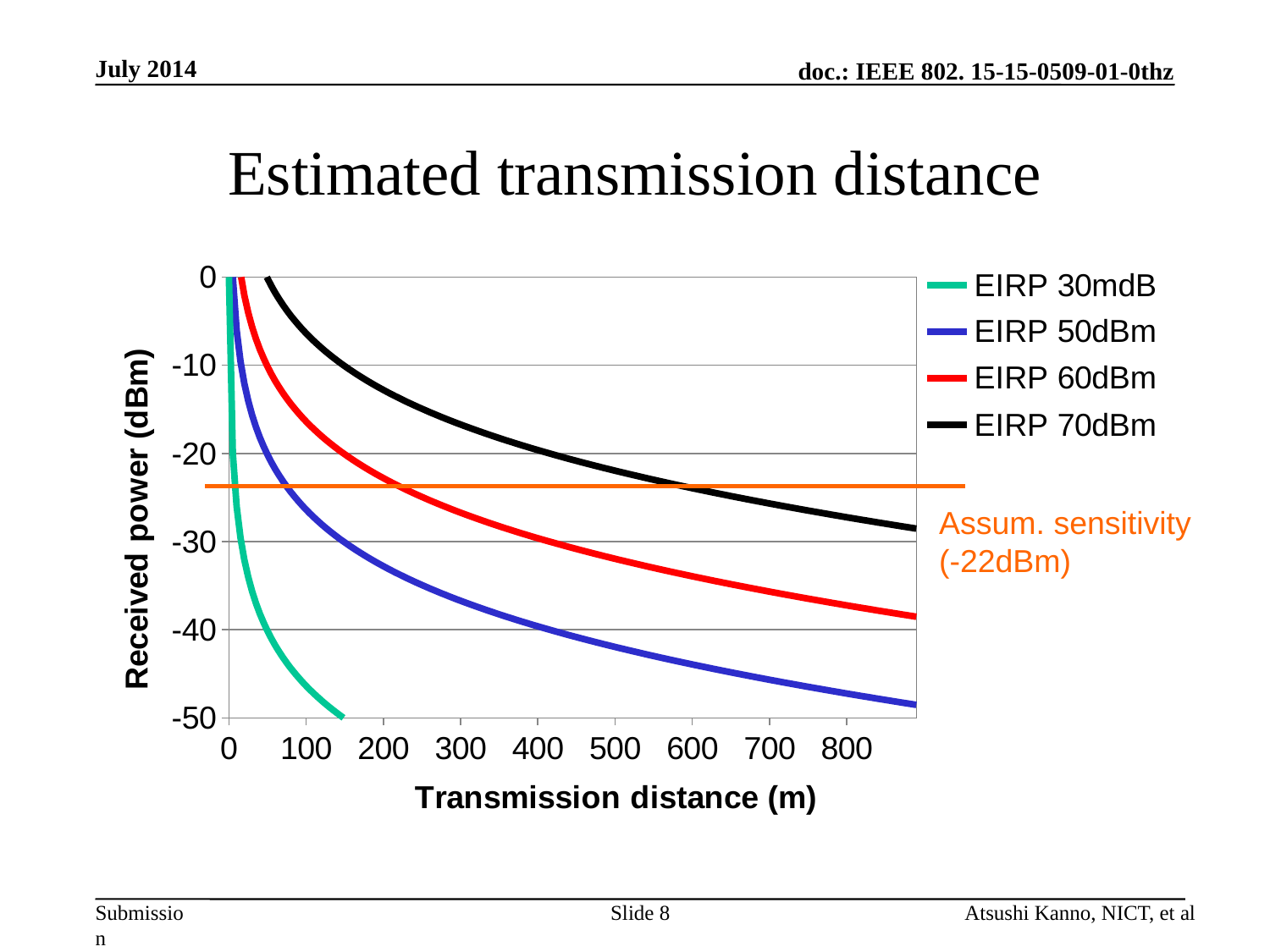
Is the received power for EIRP 50dBm at 800 m greater or less than -40 dBm? less What kind of chart is shown on the slide? Line chart How many series does the legend list? 4 What is the title of the chart? Estimated transmission distance Is the received power for EIRP 60dBm at 800 m greater or less than -30 dBm? less Is the received power for EIRP 70dBm at 200 m greater or less than -20 dBm? greater What does the orange horizontal line on the chart represent? Assum. sensitivity (-22dBm) Which series has the highest received power at any given transmission distance? EIRP 70dBm Which series has the lowest received power at any given transmission distance? EIRP 30mdB As transmission distance increases, does the received power rise or fall? Fall At a transmission distance of 400 m, which series has the higher received power, EIRP 70dBm or EIRP 50dBm? EIRP 70dBm